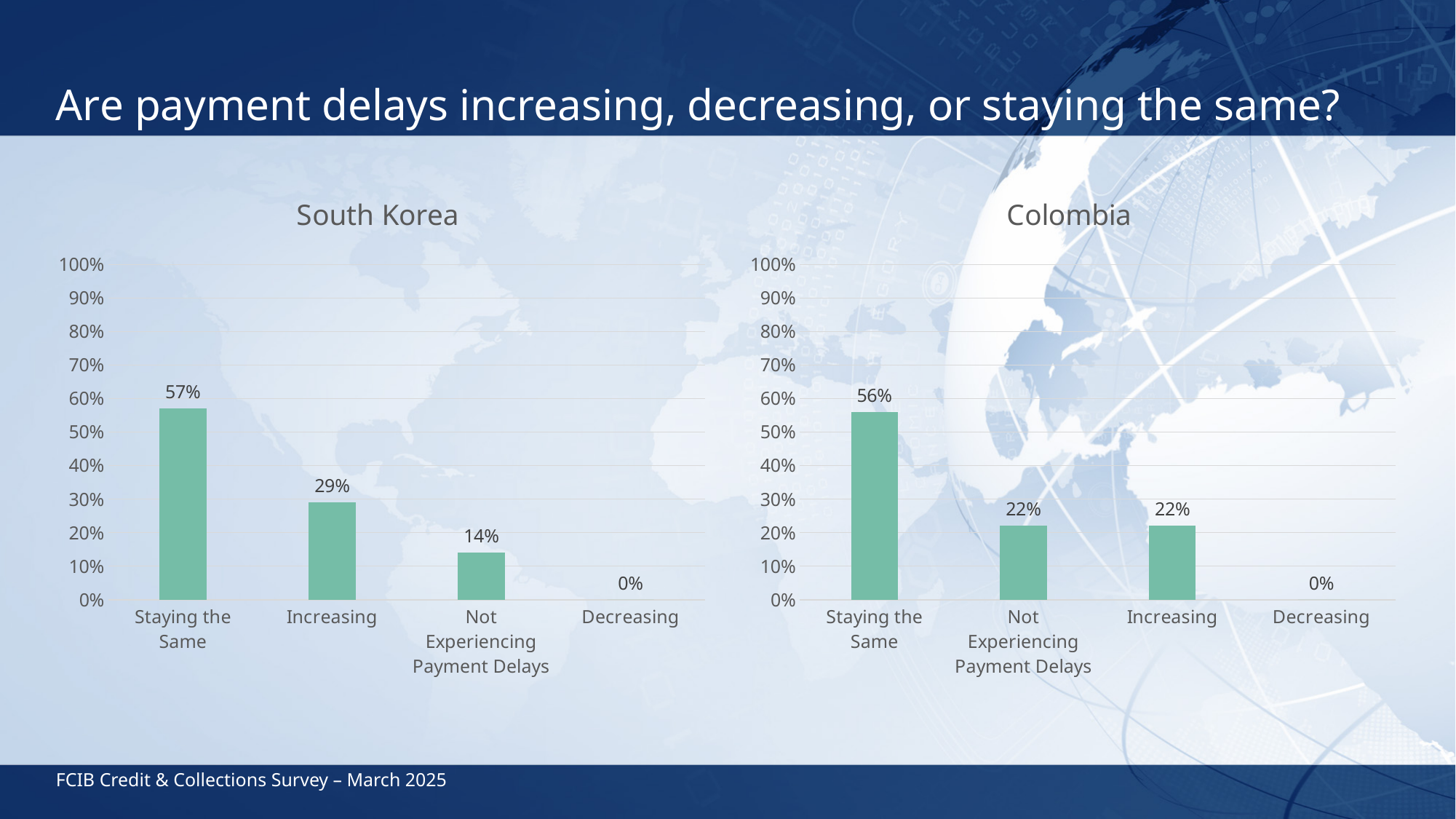
In the South Korea chart, what is the difference between Staying the Same and Increasing? 28% In the Colombia chart, what is the difference between Staying the Same and Increasing? 34% In the South Korea chart, what is the value for Staying the Same? 57% In the South Korea chart, what is the value for Increasing? 29% In the South Korea chart, is the value for Not Experiencing Payment Delays greater or less than 20%? less What kind of chart is the South Korea chart? bar chart What is the title of the chart on the right side of the slide? Colombia In the Colombia chart, which category has the highest value? Staying the Same In the South Korea chart, which category has the lowest value? Decreasing How many categories are shown in the Colombia chart? 4 Which is larger: Staying the Same in the South Korea chart or Staying the Same in the Colombia chart? South Korea In the Colombia chart, what is the value for Not Experiencing Payment Delays? 22%